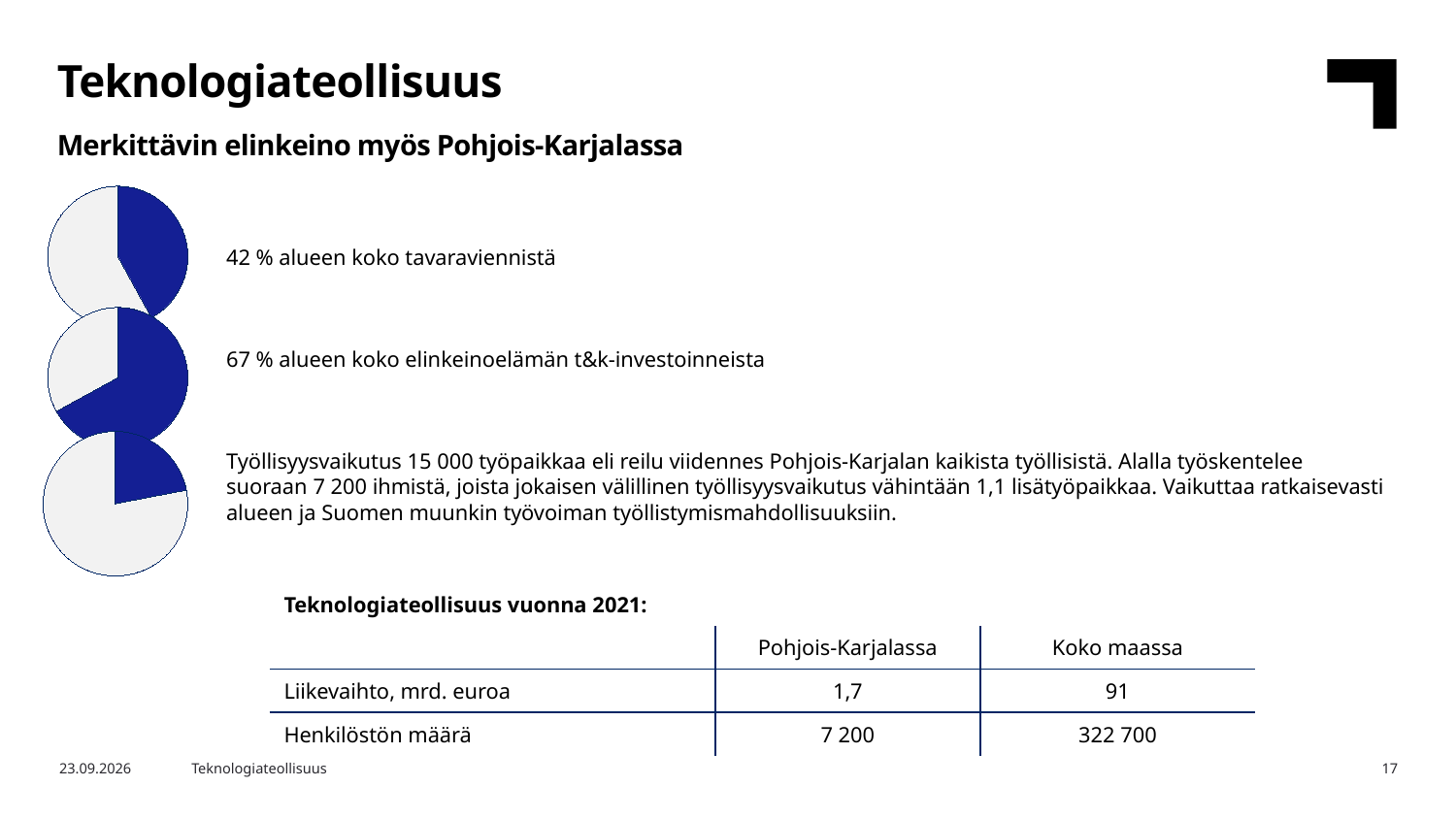
In the middle pie chart, what share of the region's business R&D investments does the dark blue slice represent? 67 % In the bottom pie chart, is the dark blue slice greater or less than 50 %? less How many slices does each pie chart have? 2 In the middle pie chart, is the dark blue slice greater or less than 50 %? greater What two colours are used for the slices in the pie charts? Dark blue and light grey Is the dark blue slice larger in the top pie chart or in the middle pie chart? Middle Which pie chart has the largest dark blue slice: the top, middle or bottom one? Middle Which pie chart has the smallest dark blue slice: the top, middle or bottom one? Bottom What is the difference in percentage points between the dark blue shares of the middle pie chart (67 %) and the top pie chart (42 %)? 25 How many pie charts are on the slide? 3 In the top pie chart, what share of the region's total goods exports does the dark blue slice represent? 42 % What kind of charts are shown on the left side of the slide? Pie charts